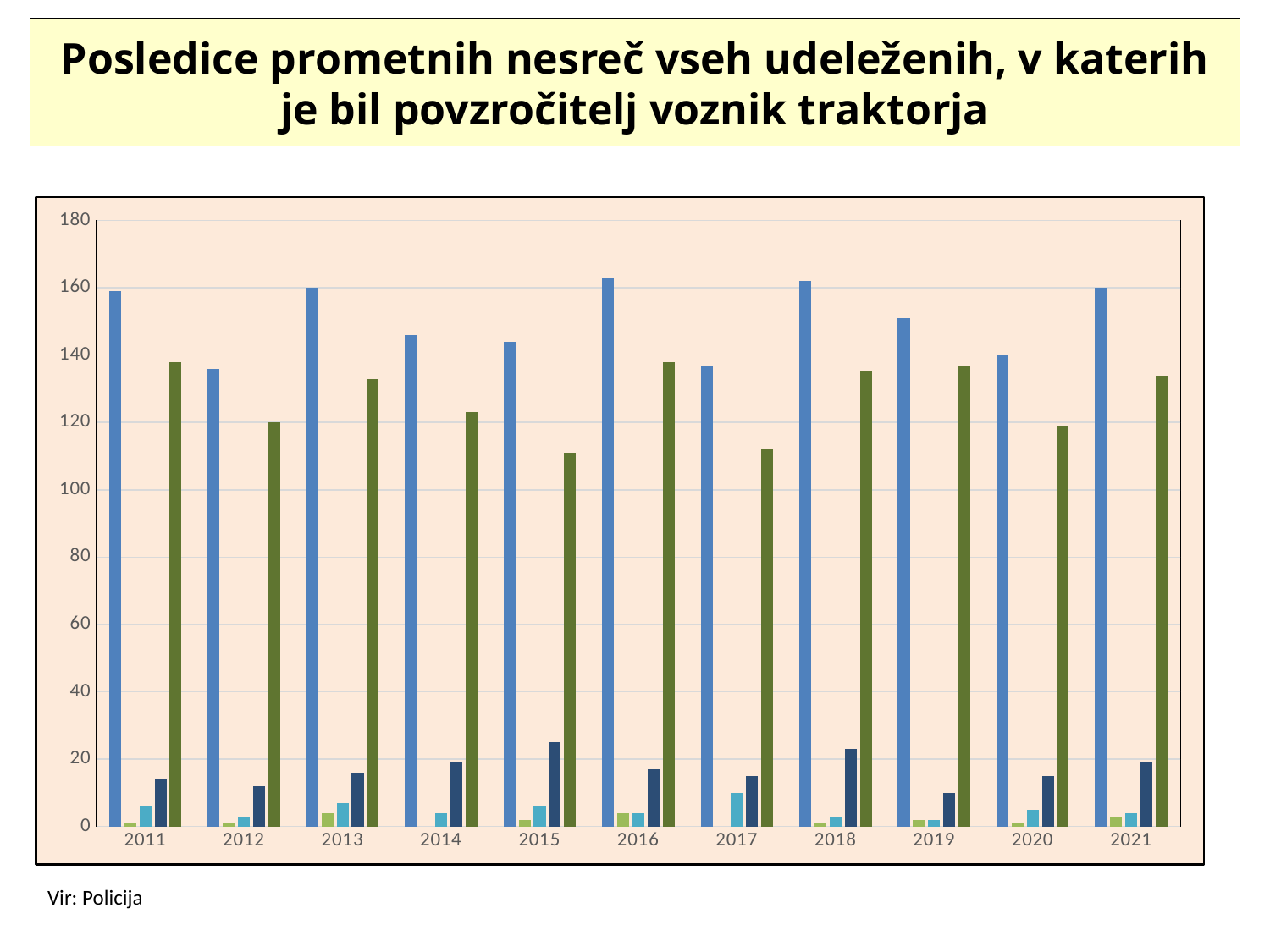
Is the value of the olive green bar for 2015 greater or less than 120? less Is the value of the dark blue bar for 2019 greater or less than 20? less Which year has the larger olive green bar, 2011 or 2012? 2011 What kind of chart is shown on the slide? bar chart Is the value of the light blue bar for 2011 greater or less than 140? greater How many years are shown on the x axis of the chart? 11 What is the title of the slide containing the chart? Posledice prometnih nesreč vseh udeleženih, v katerih je bil povzročitelj voznik traktorja In 2011, which is larger: the light blue bar or the olive green bar? the light blue bar What source is cited below the chart? Vir: Policija